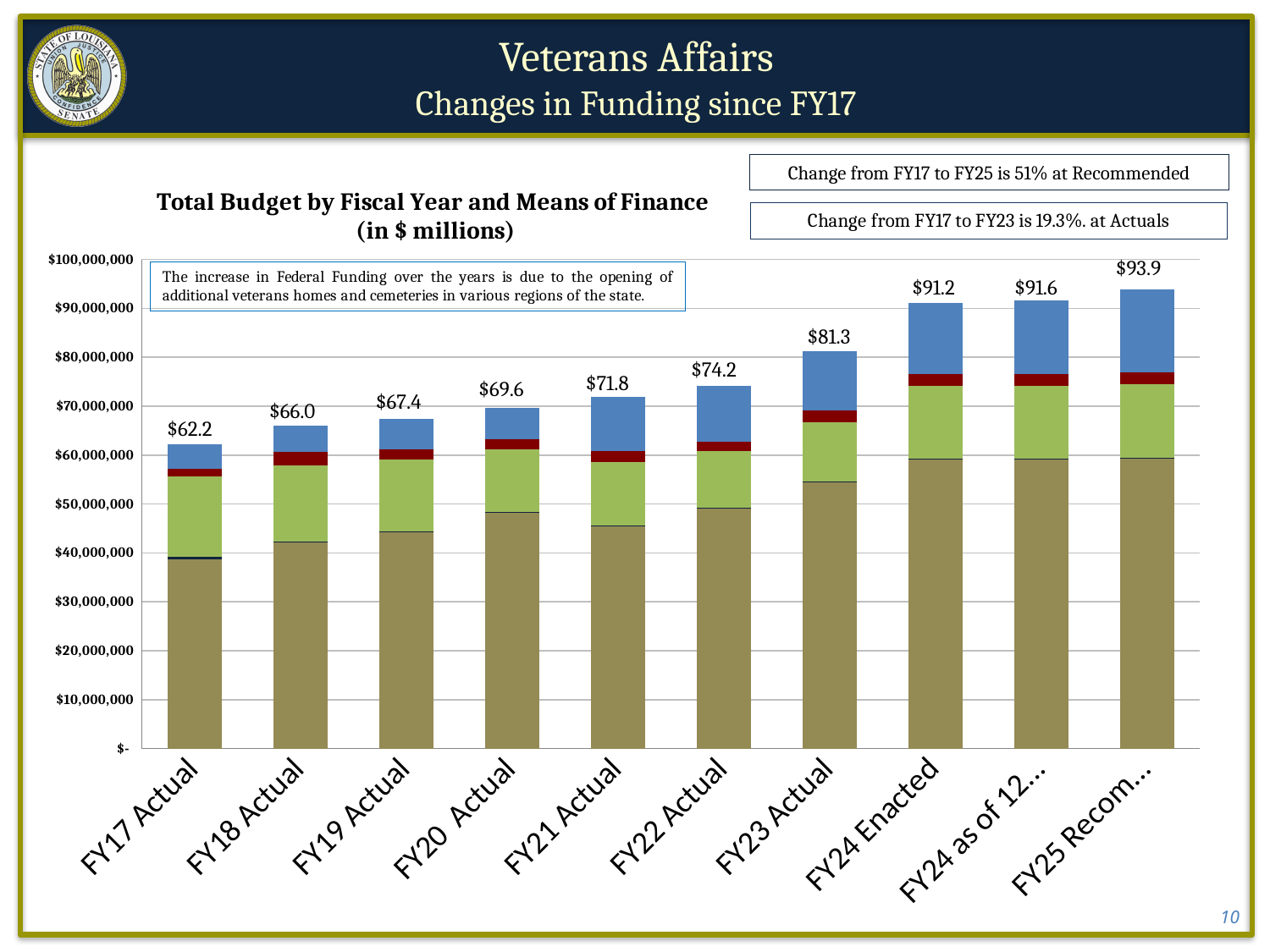
Do the total budget values rise or fall from FY17 Actual to FY25 Recommended? Rise How many fiscal year bars are shown in the chart? 10 What is the total budget labeled for FY17 Actual? $62.2 Which fiscal year bar has the highest total budget? FY25 Recom... What is the difference between the FY23 Actual total ($81.3) and the FY22 Actual total ($74.2)? $7.1 Which fiscal year bar has the lowest total budget? FY17 Actual What is the total budget labeled for FY24 Enacted? $91.2 Which is larger, the total for FY20 Actual or the total for FY21 Actual? FY21 Actual Is the bottom (brown) segment of the FY23 Actual bar greater or less than $50,000,000? greater What kind of chart is shown on the slide? Stacked bar chart What is the total budget labeled for FY23 Actual? $81.3